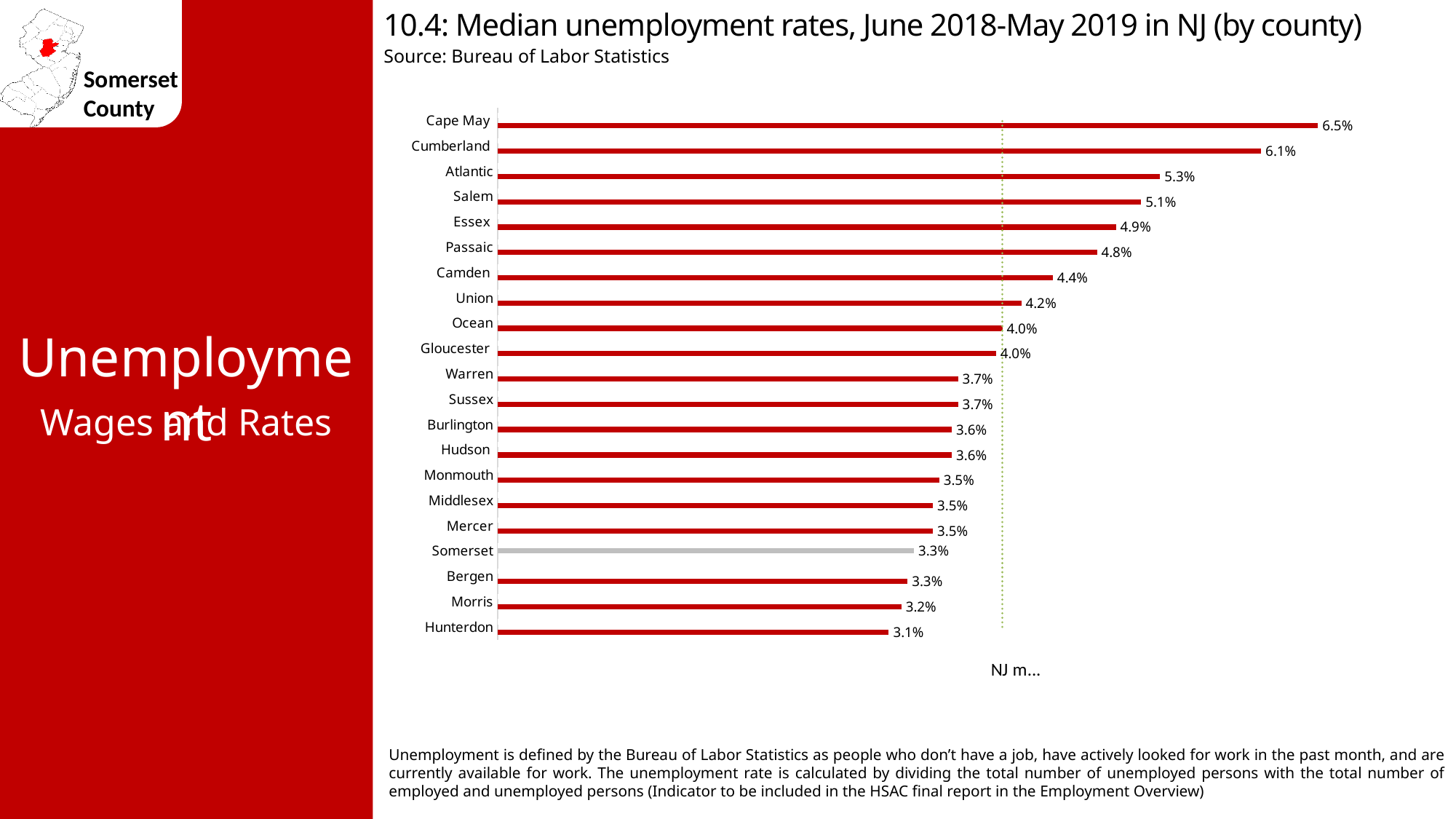
Which county's bar is shown in grey rather than red? Somerset What type of chart is used on this slide? Bar chart What is the difference between the median unemployment rates of Cape May and Hunterdon? 3.4% What is the difference between the median unemployment rates of Cumberland and Somerset? 2.8% Which has a higher median unemployment rate, Essex or Union? Essex Which county has the highest median unemployment rate? Cape May What is the median unemployment rate for Somerset County? 3.3% How many counties are shown in the chart? 21 Which county has the lowest median unemployment rate? Hunterdon Which has a higher median unemployment rate, Morris or Passaic? Passaic What is the median unemployment rate for Camden? 4.4% What is the median unemployment rate for Cape May? 6.5%